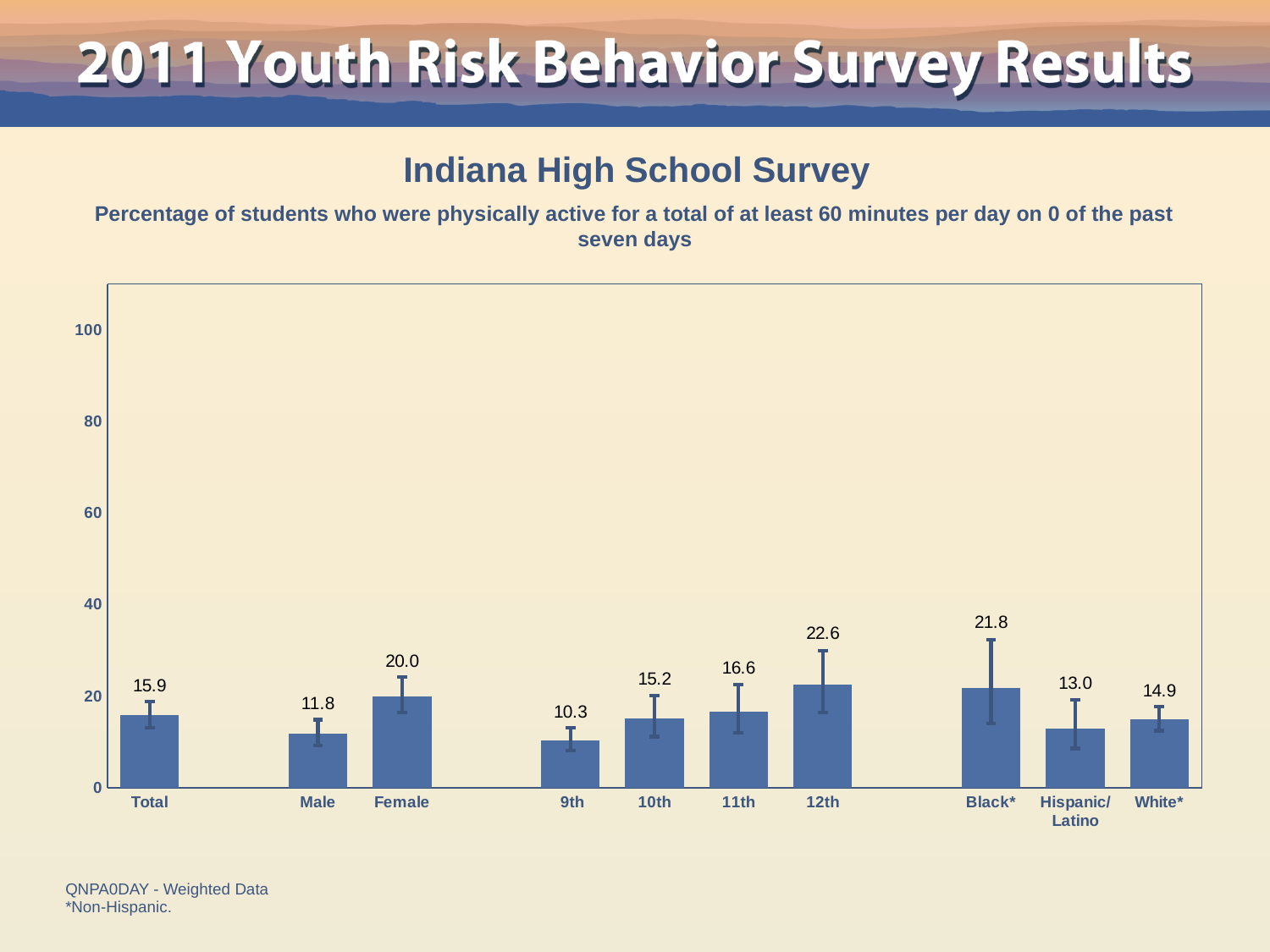
What is the value for Female? 20.0 What is the title of the chart? Indiana High School Survey What is the value for Hispanic/Latino? 13.0 Do the values rise or fall from 9th to 12th grade? rise Which is larger, the value for Black* or the value for White*? Black* Is the value for 12th greater or less than 20? greater What is the difference between the Female and Male values? 8.2 What kind of chart is this? bar chart Which category has the highest value? 12th What is the value for Total? 15.9 Which category has the lowest value? 9th How many categories are shown on the x axis? 10